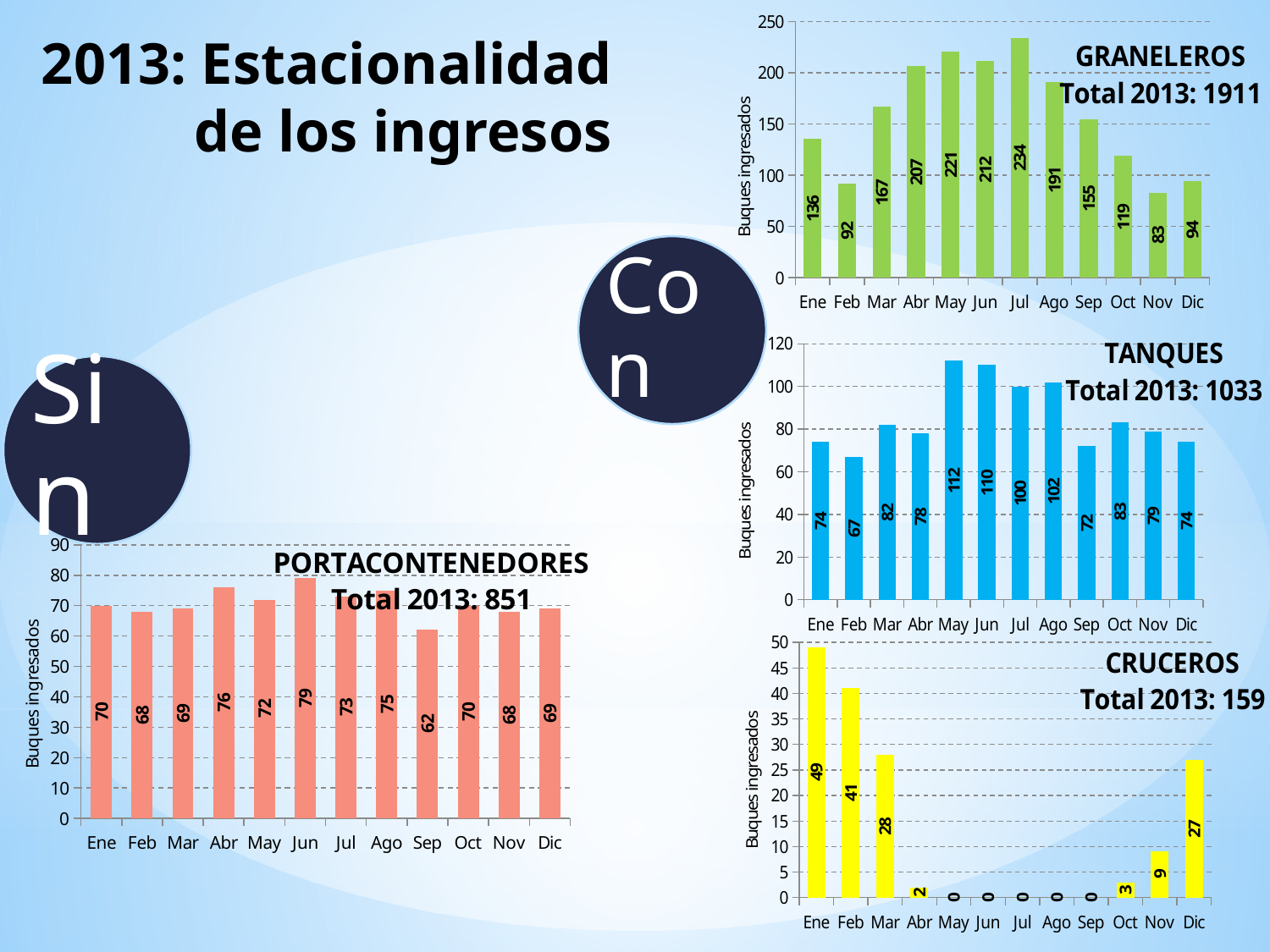
In the TANQUES chart, which month has the lowest value? Feb In the CRUCEROS chart, how many months have a value of 0? 5 In the GRANELEROS chart, what is the difference between the values for May and Feb? 129 In the TANQUES chart, which is larger, the value for Jul or the value for Ago? Ago In the GRANELEROS chart, what is the value for Jul? 234 In the PORTACONTENEDORES chart, which month has the highest value? Jun In the CRUCEROS chart, what is the value for Ene? 49 In the PORTACONTENEDORES chart, what is the value for Sep? 62 In the TANQUES chart, what is the value for May? 112 What kind of chart is the TANQUES chart? Bar chart What total for 2013 is shown on the CRUCEROS chart? 159 In the GRANELEROS chart, which month has the lowest value? Nov